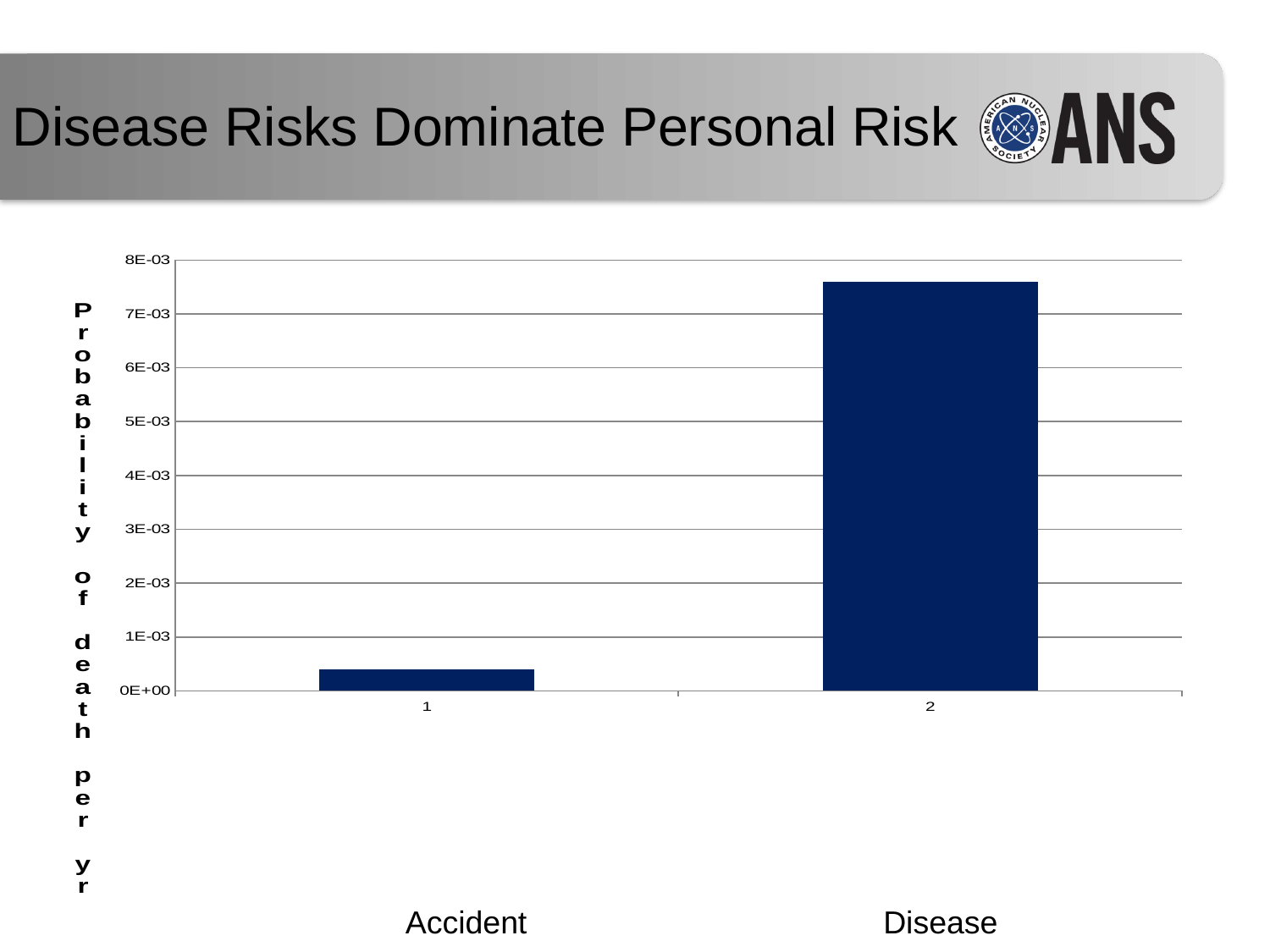
How many bars are plotted in the chart? 2 Which is larger, the value for Accident or the value for Disease? Disease What kind of chart is shown on the slide? bar chart Which category has the lowest probability of death per year? Accident What is the label on the vertical axis of the chart? Probability of death per yr Is the value for Disease greater or less than 8E-03? less Do the values rise or fall from Accident to Disease along the x axis? rise Is the value for Disease greater or less than 7E-03? greater Is the value for Accident greater or less than 1E-03? less What is the title of the slide containing the chart? Disease Risks Dominate Personal Risk Which category has the highest probability of death per year? Disease